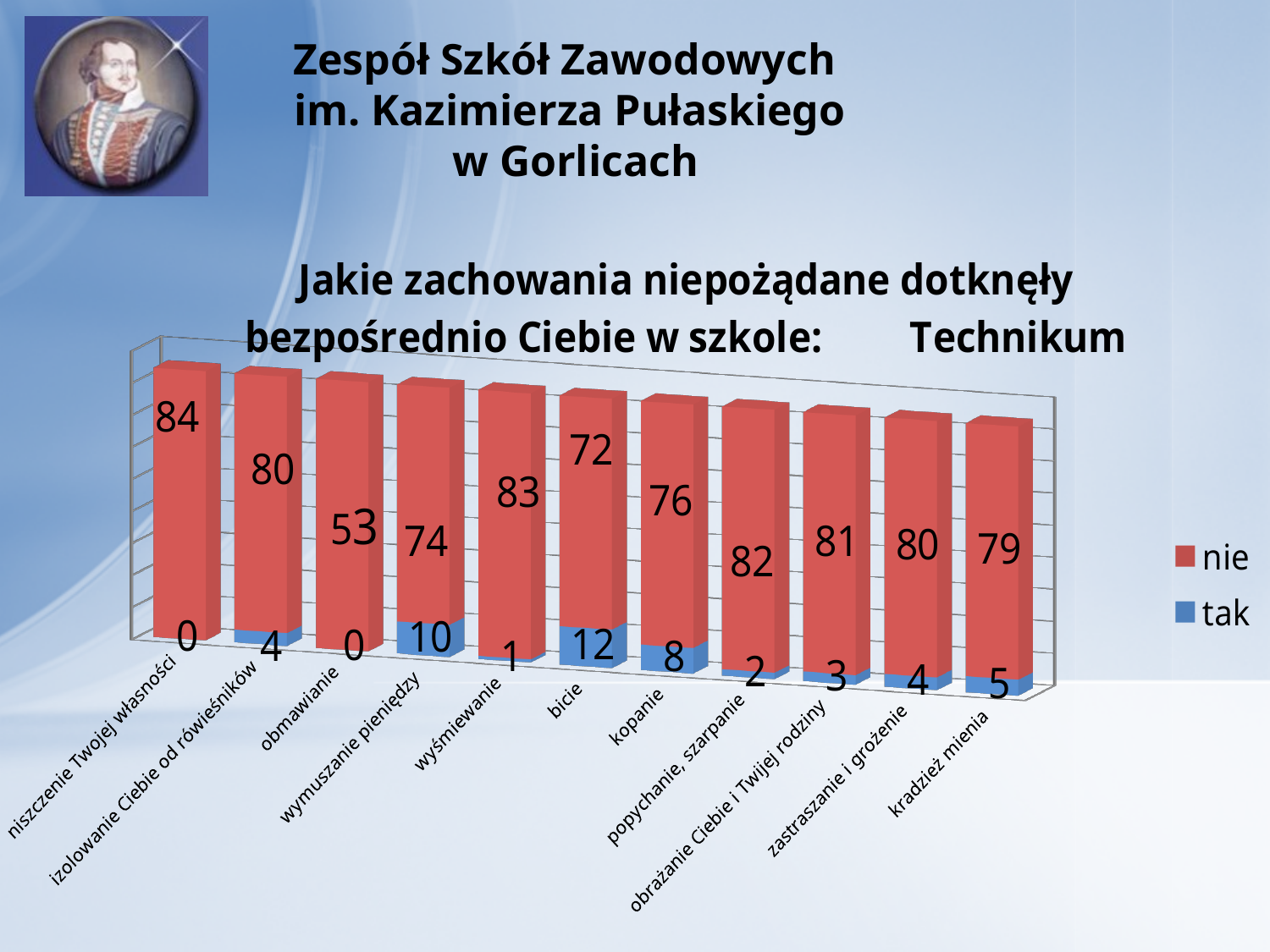
What is the total of the stacked bar for "bicie"? 84 What is the value of the "nie" series for "niszczenie Twojej własności"? 84 What is the value of the "tak" series for "wymuszanie pieniędzy"? 10 What kind of chart is shown on the slide? bar chart How many series does the legend list? 2 What is the value of the "tak" series for "bicie"? 12 What is the difference between the "tak" values for "bicie" and "wymuszanie pieniędzy"? 2 Which category has the highest "tak" value? bicie Which has a larger "nie" value: "wyśmiewanie" or "kopanie"? wyśmiewanie How many categories are shown on the x axis of the chart? 11